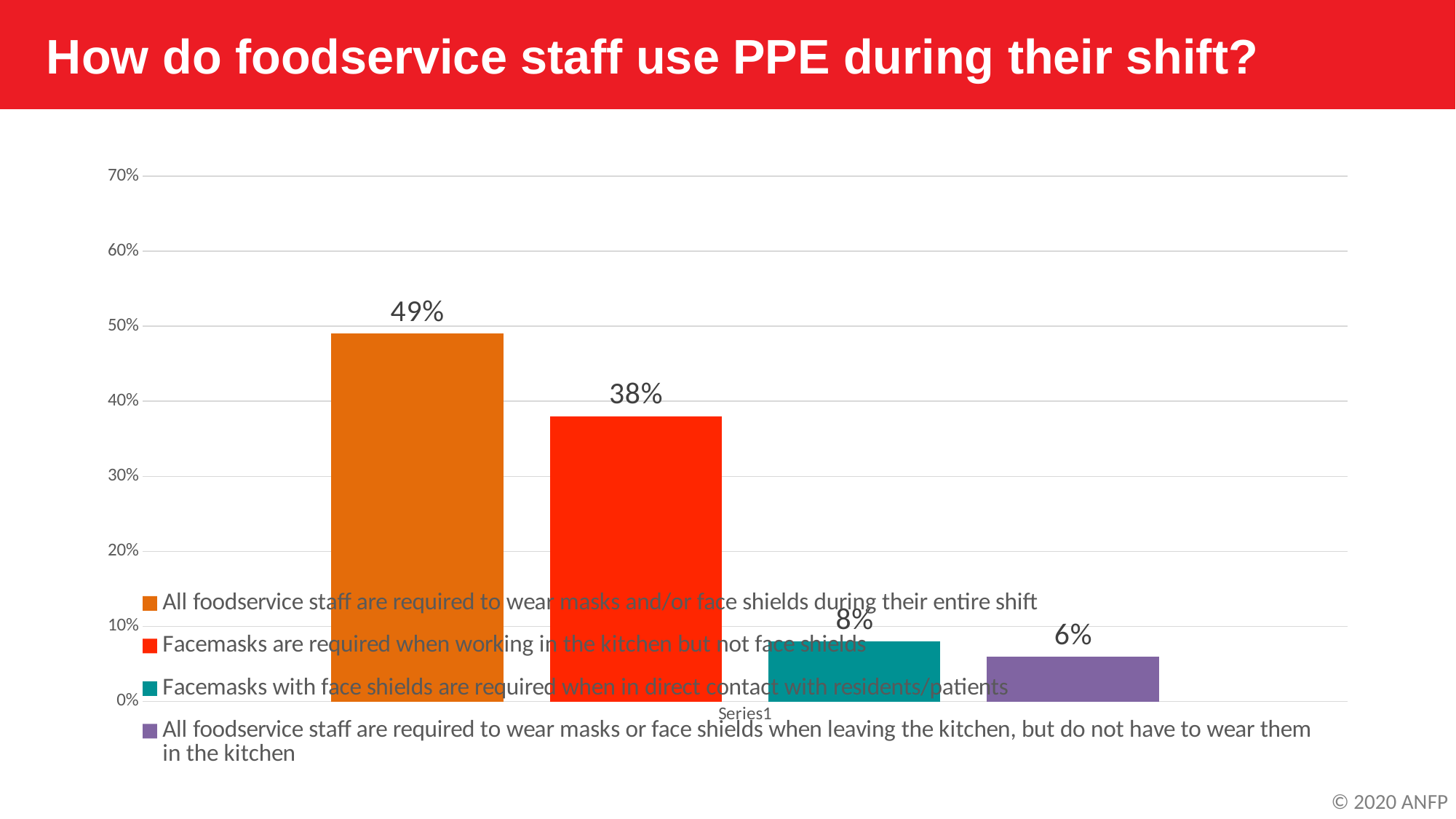
What colour is the bar for facemasks with face shields required when in direct contact with residents/patients? Teal What percentage of respondents said staff are required to wear masks or face shields when leaving the kitchen, but not in the kitchen? 6% What percentage of respondents said facemasks with face shields are required when in direct contact with residents/patients? 8% How many bars are plotted in the chart? 4 How many entries does the legend list? 4 Which is larger: the percentage for facemasks with face shields when in direct contact with residents/patients, or the percentage for masks or face shields only when leaving the kitchen? Facemasks with face shields are required when in direct contact with residents/patients Which PPE practice has the highest percentage? All foodservice staff are required to wear masks and/or face shields during their entire shift What type of chart is shown on the slide? Bar chart What percentage of respondents said facemasks are required when working in the kitchen but not face shields? 38% Which PPE practice has the lowest percentage? All foodservice staff are required to wear masks or face shields when leaving the kitchen, but do not have to wear them in the kitchen What is the difference between the percentage for masks and/or face shields during the entire shift and the percentage for facemasks in the kitchen but not face shields? 11% What percentage of respondents said all foodservice staff are required to wear masks and/or face shields during their entire shift? 49%